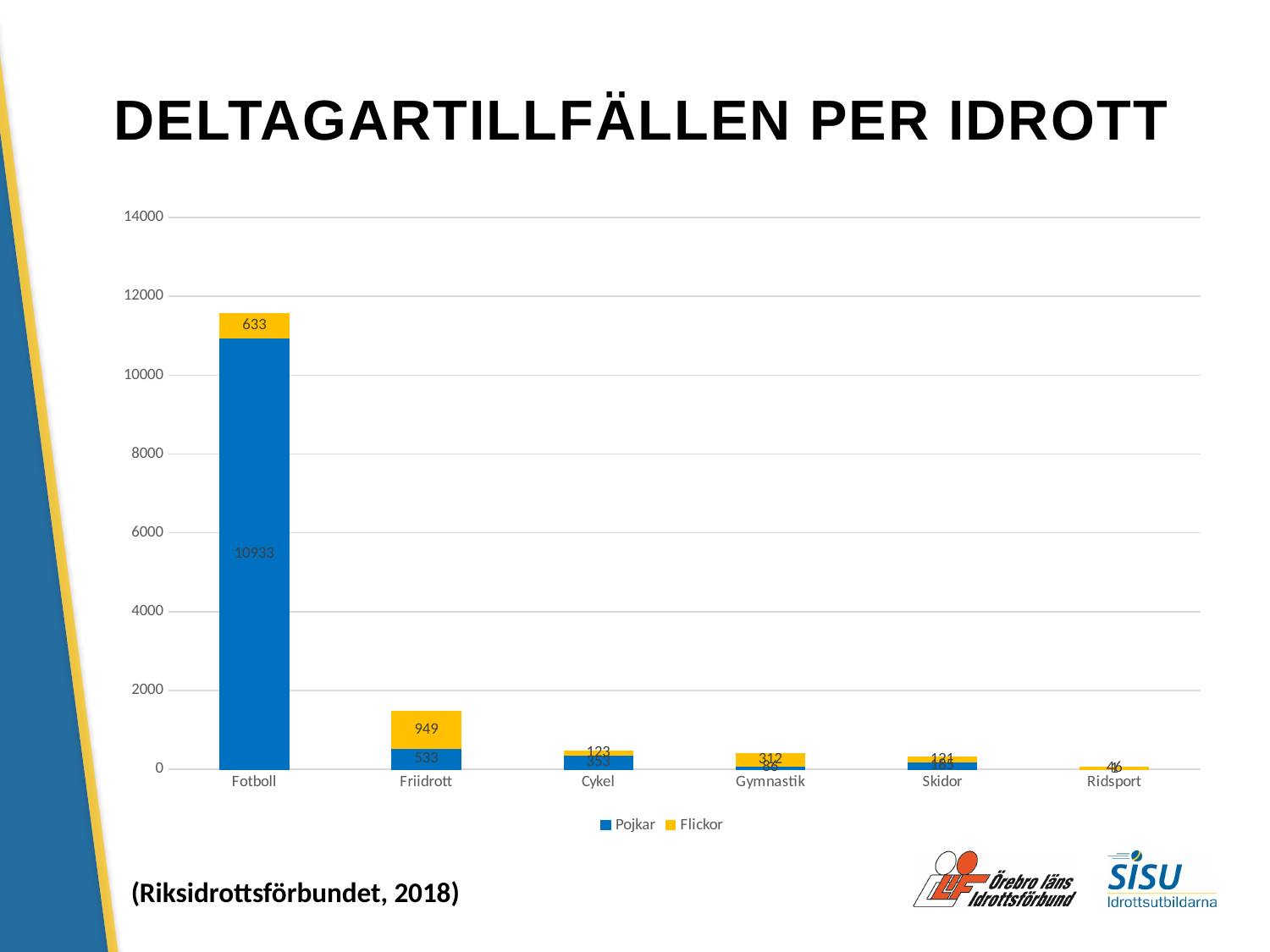
What is the Flickor value for Fotboll? 633 What is the Pojkar value for Fotboll? 10933 Which sport has the lowest total number of deltagartillfällen? Ridsport Which sport has the highest total number of deltagartillfällen? Fotboll For Friidrott, which is larger: the Pojkar value or the Flickor value? Flickor How many series does the legend list? 2 What is the Pojkar value for Friidrott? 533 How many sports (categories) are shown on the x axis? 6 What kind of chart is shown on the slide? bar chart What is the difference between the Pojkar and Flickor values for Fotboll? 10300 What is the total of the stacked bar for Friidrott? 1482 What is the Flickor value for Friidrott? 949